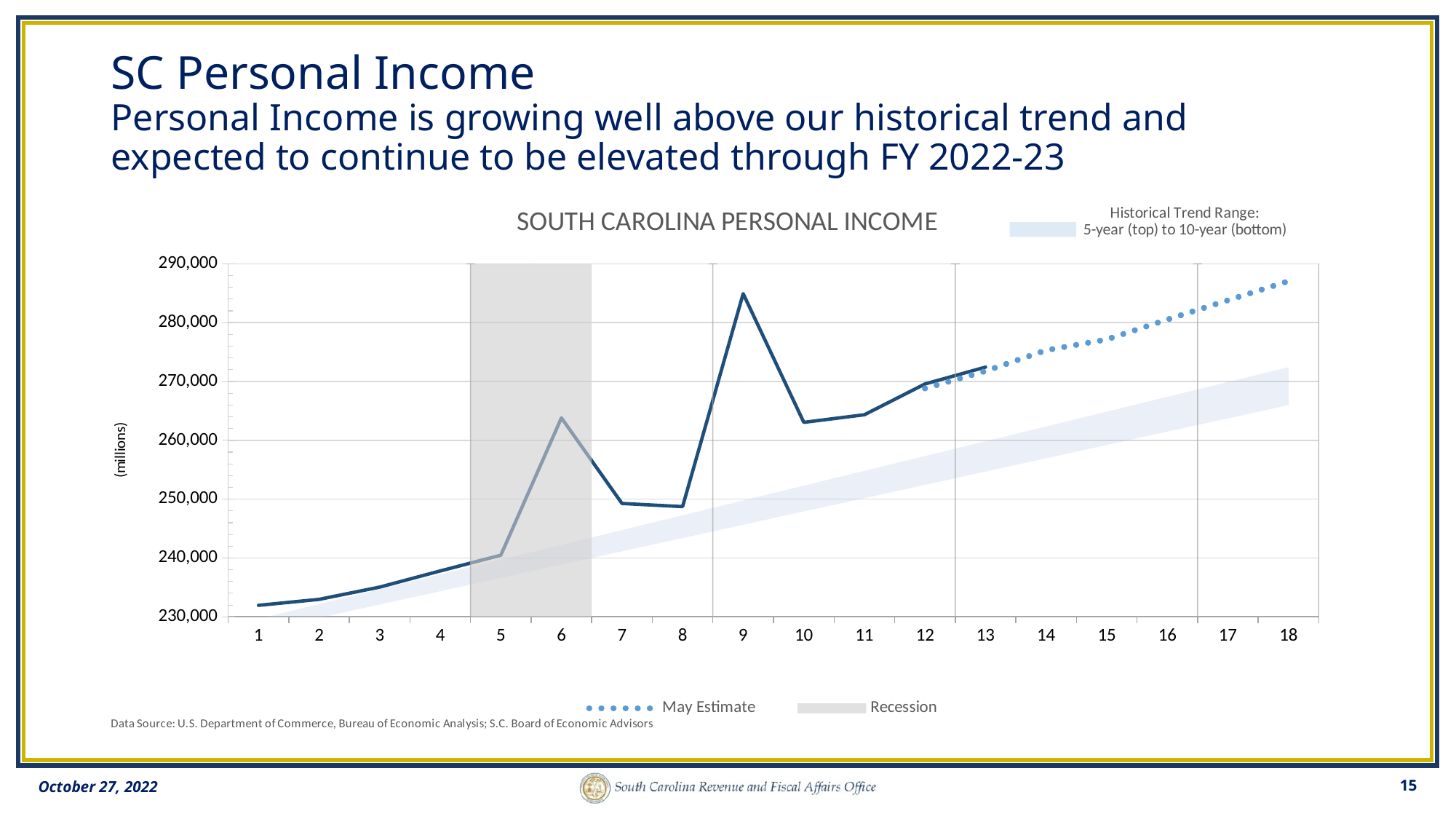
Which is larger, the value at point 9 or the value at point 6? point 9 Is the May Estimate dotted line at point 18 greater or less than 280,000? greater Is the value of the solid line at point 8 greater or less than 250,000? less Does the May Estimate dotted line rise or fall from point 13 to point 18? rise At which x-axis point is the solid personal income line at its lowest value? 1 Which two entries does the legend below the chart list? May Estimate and Recession What kind of chart is shown on the slide? line chart What is the title of the chart? SOUTH CAROLINA PERSONAL INCOME At which x-axis point does the solid personal income line reach its highest value? 9 How many points are labelled on the x axis? 18 Is the value of the solid line at point 9 greater or less than 280,000? greater